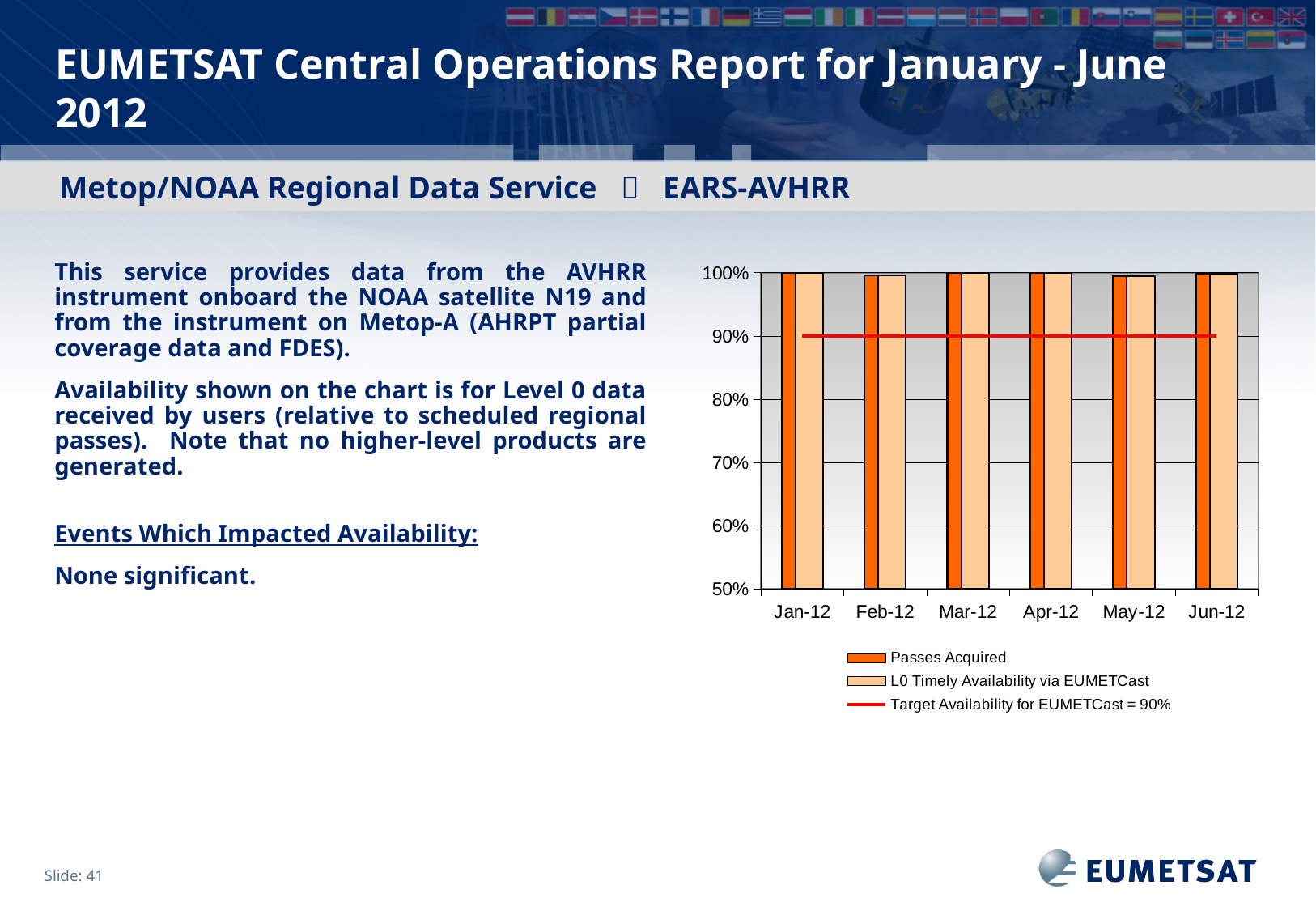
Is the value for L0 Timely Availability via EUMETCast in May-12 greater or less than 80%? greater What is the first month shown on the x axis of the chart? Jan-12 Is the value for Passes Acquired in Jan-12 greater or less than 90%? greater What is the target availability for EUMETCast shown by the red line? 90% Which legend entry is represented by the red line? Target Availability for EUMETCast = 90% Is the value for L0 Timely Availability via EUMETCast in Mar-12 greater or less than 90%? greater What kind of chart is shown on the slide? combination bar and line chart How many entries does the chart legend list? 3 What is the lowest value shown on the y axis of the chart? 50% How many months are shown on the x axis of the chart? 6